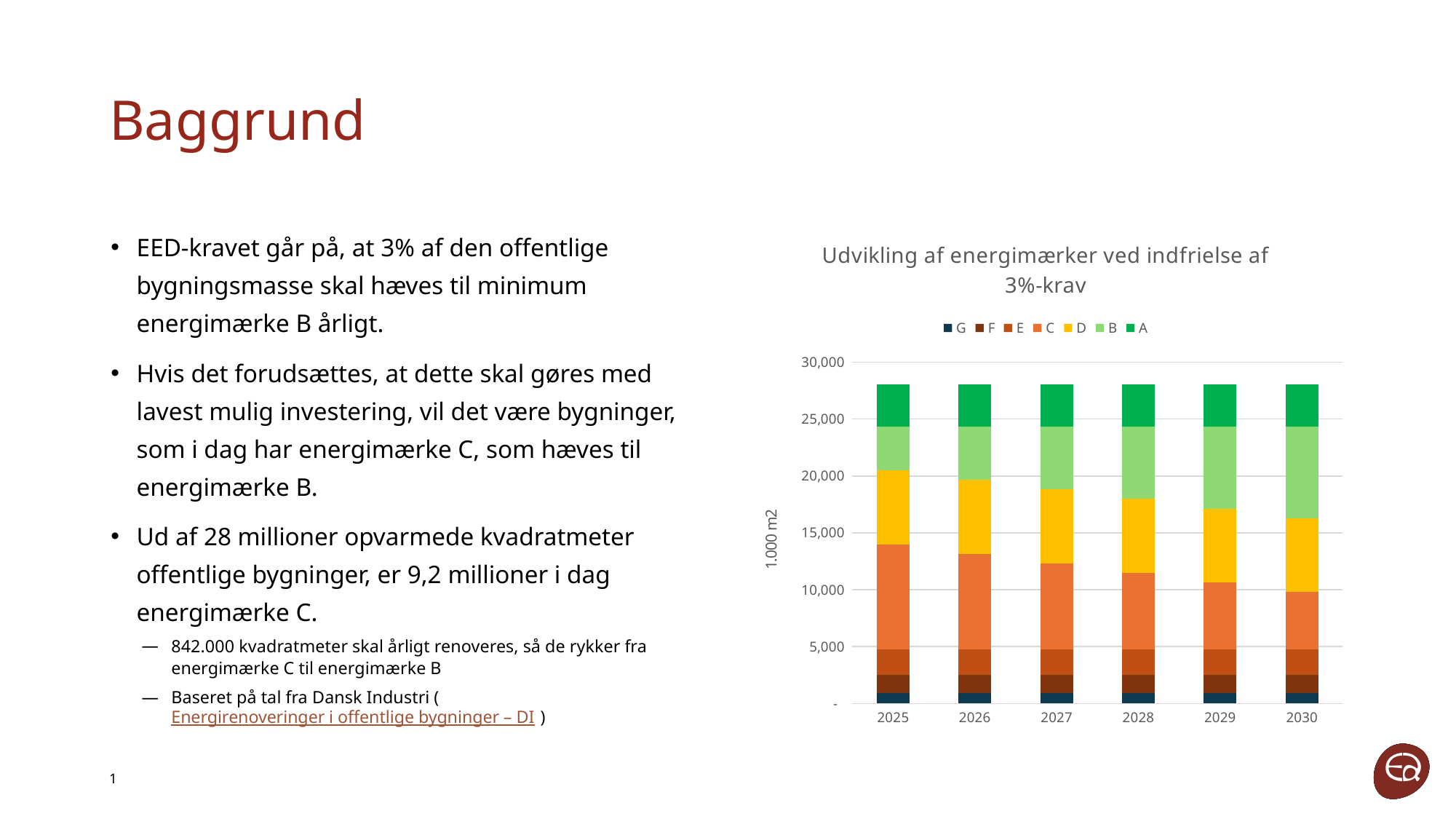
Is the total height of the 2030 bar greater or less than 30,000? less Does the B segment (light green) rise or fall from 2025 to 2030? Rise What is the title of the chart? Udvikling af energimærker ved indfrielse af 3%-krav In which year is the C segment smallest? 2030 How many years are shown on the x axis of the chart? 6 Which year has the larger B segment, 2026 or 2029? 2029 Does the C segment (orange) rise or fall from 2025 to 2030? Fall What kind of chart is shown on the slide? Stacked bar chart Is the total height of the 2025 bar greater or less than 25,000? greater What is the label on the vertical axis of the chart? 1.000 m2 How many series does the chart legend list? 7 Which year has the larger C segment, 2025 or 2030? 2025